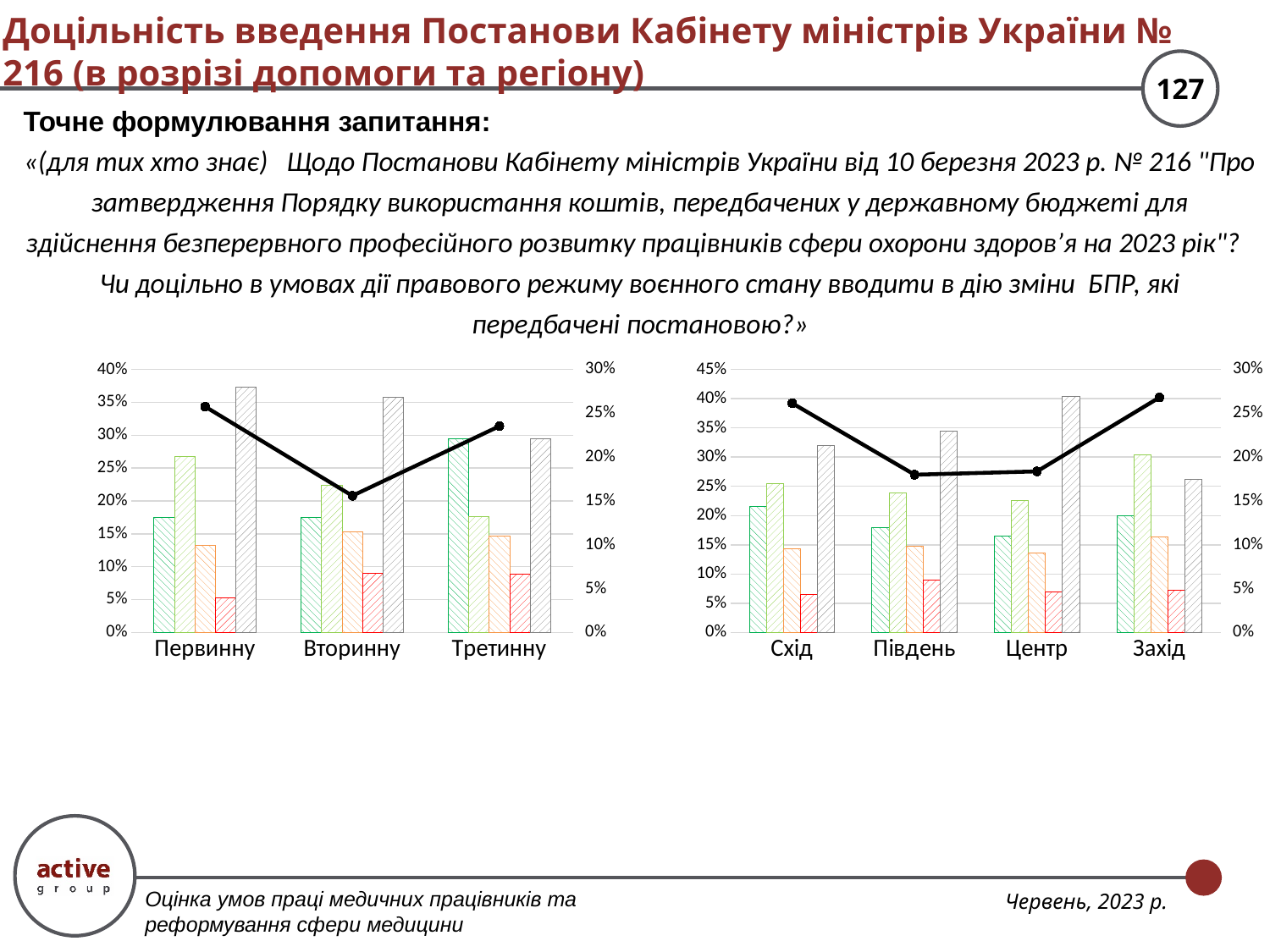
On the left chart, is the black line value for Вторинну (right axis) greater or less than 20%? less On the right chart, is the black line value for Захід (right axis) greater or less than 25%? greater On the right chart, which category has the tallest bar? Центр How many categories are shown on the x axis of the left chart? 3 What kind of chart is the left chart (categories Первинну, Вторинну, Третинну)? Combined bar and line chart On the left chart, is the black line value for Третинну (right axis) greater or less than 20%? greater How many categories are shown on the x axis of the right chart? 4 On the left chart, for which category does the black line reach its highest point? Первинну On the right chart, does the black line rise or fall from Центр to Захід? rise On the left chart, for which category does the black line reach its lowest point? Вторинну